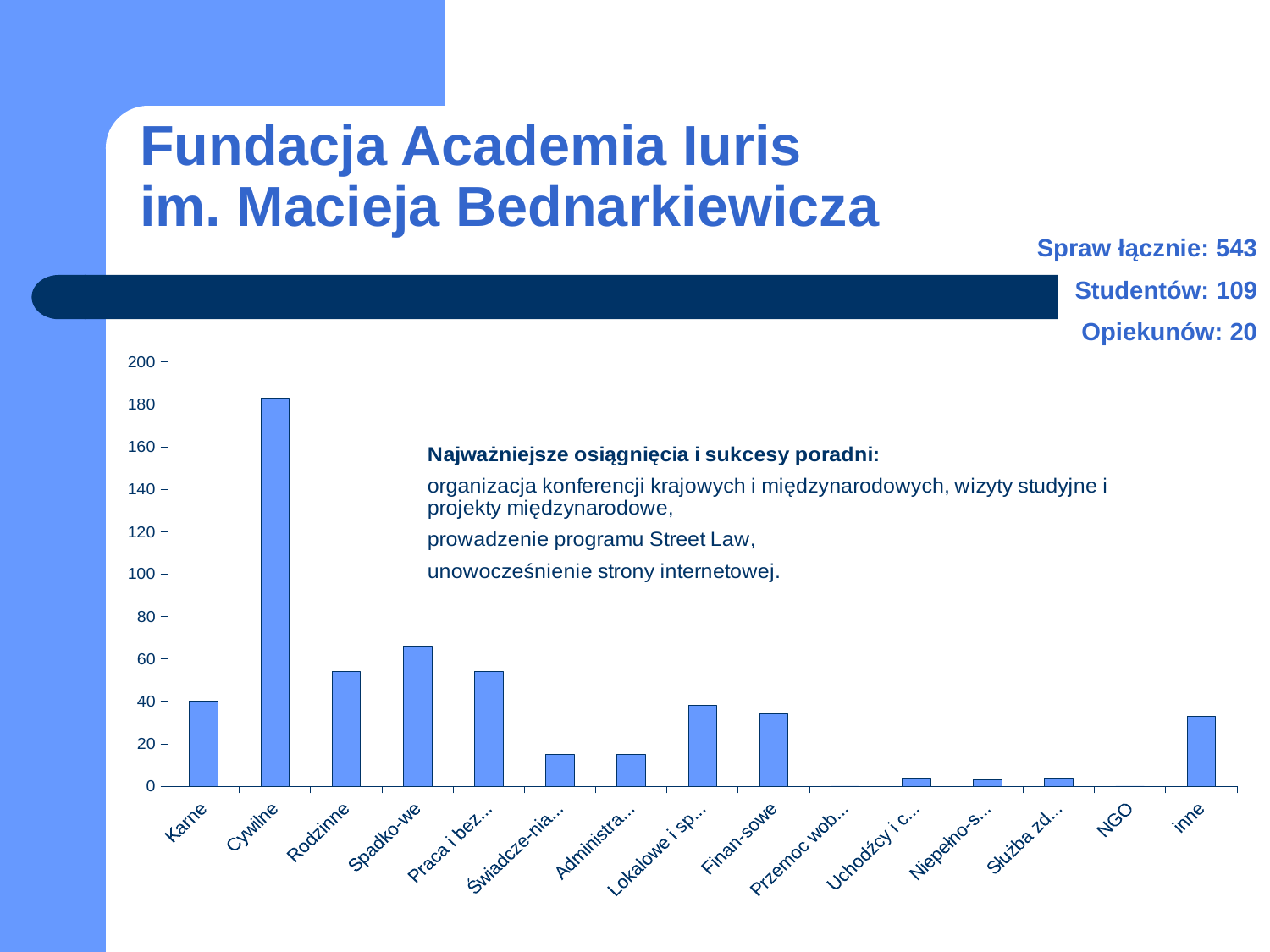
Which category has the highest bar in the chart? Cywilne How many categories are shown on the x axis of the chart? 15 Is the value for Rodzinne greater or less than 60? less Which is larger, the value for Karne or the value for Cywilne? Cywilne What kind of chart is shown on the slide? bar chart Is the value for Spadko-we greater or less than 60? greater Is the value for Cywilne greater or less than 160? greater What is the highest value shown on the vertical axis of the chart? 200 Which is larger, the value for Lokalowe i sp... or the value for Administra...? Lokalowe i sp... Which is larger, the value for Spadko-we or the value for Rodzinne? Spadko-we